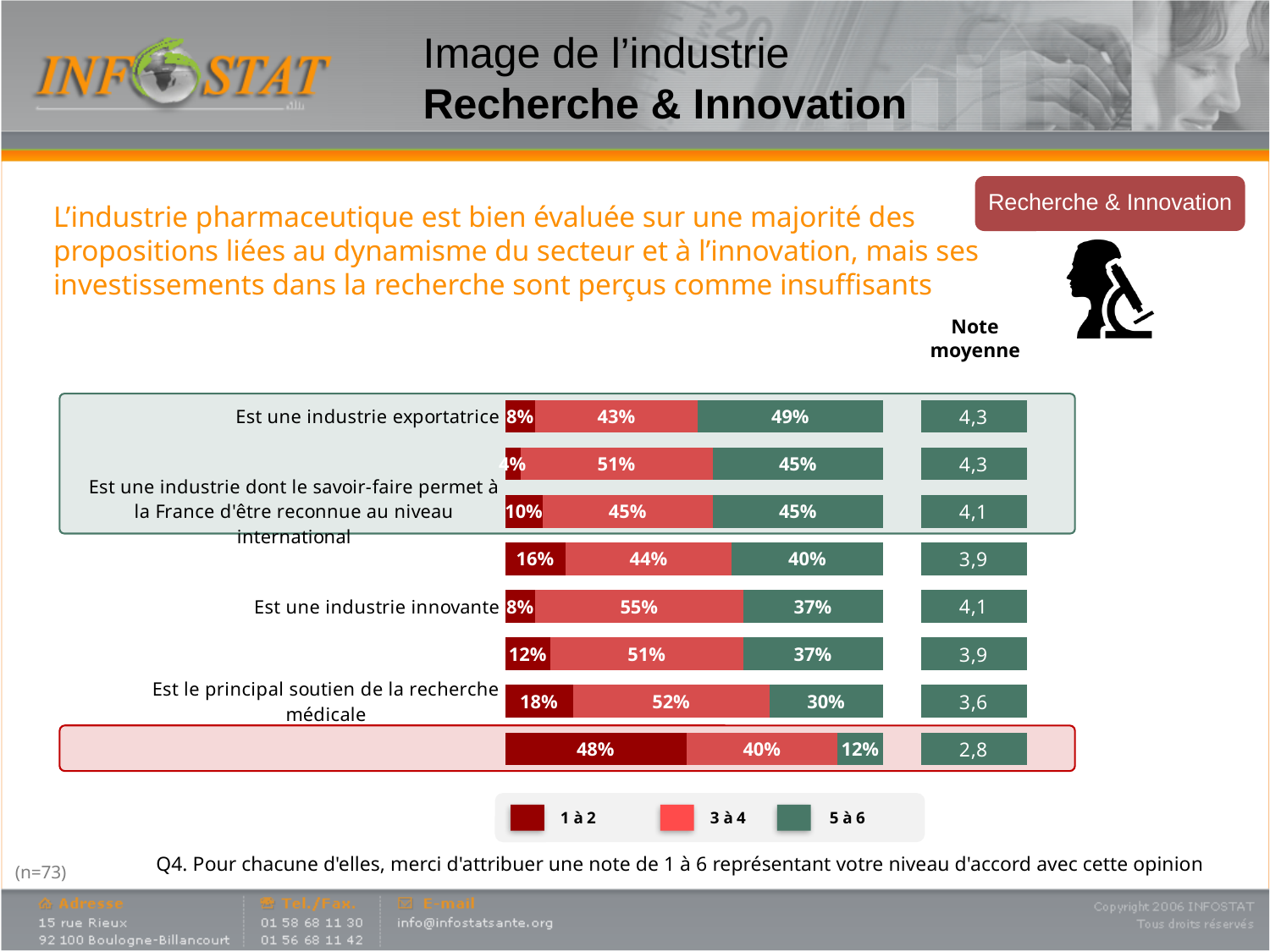
What is the value of the '5 à 6' segment for 'Est une industrie exportatrice'? 49% Which bar has the largest '1 à 2' segment? the bottom bar (48%) What is the value of the '3 à 4' segment for 'Est une industrie exportatrice'? 43% What kind of chart is shown on the slide? stacked bar chart What is the value of the '5 à 6' segment for 'Est le principal soutien de la recherche médicale'? 30% How many series does the legend list? 3 What is the value of the '3 à 4' segment for 'Est une industrie innovante'? 55% What is the 'Note moyenne' shown for 'Est une industrie exportatrice'? 4,3 What is the value of the '1 à 2' segment for 'Est une industrie innovante'? 8% What is the difference between the '3 à 4' and '5 à 6' segments for 'Est le principal soutien de la recherche médicale'? 22% What is the value of the '1 à 2' segment for 'Est le principal soutien de la recherche médicale'? 18% How many bars are plotted in the chart? 8